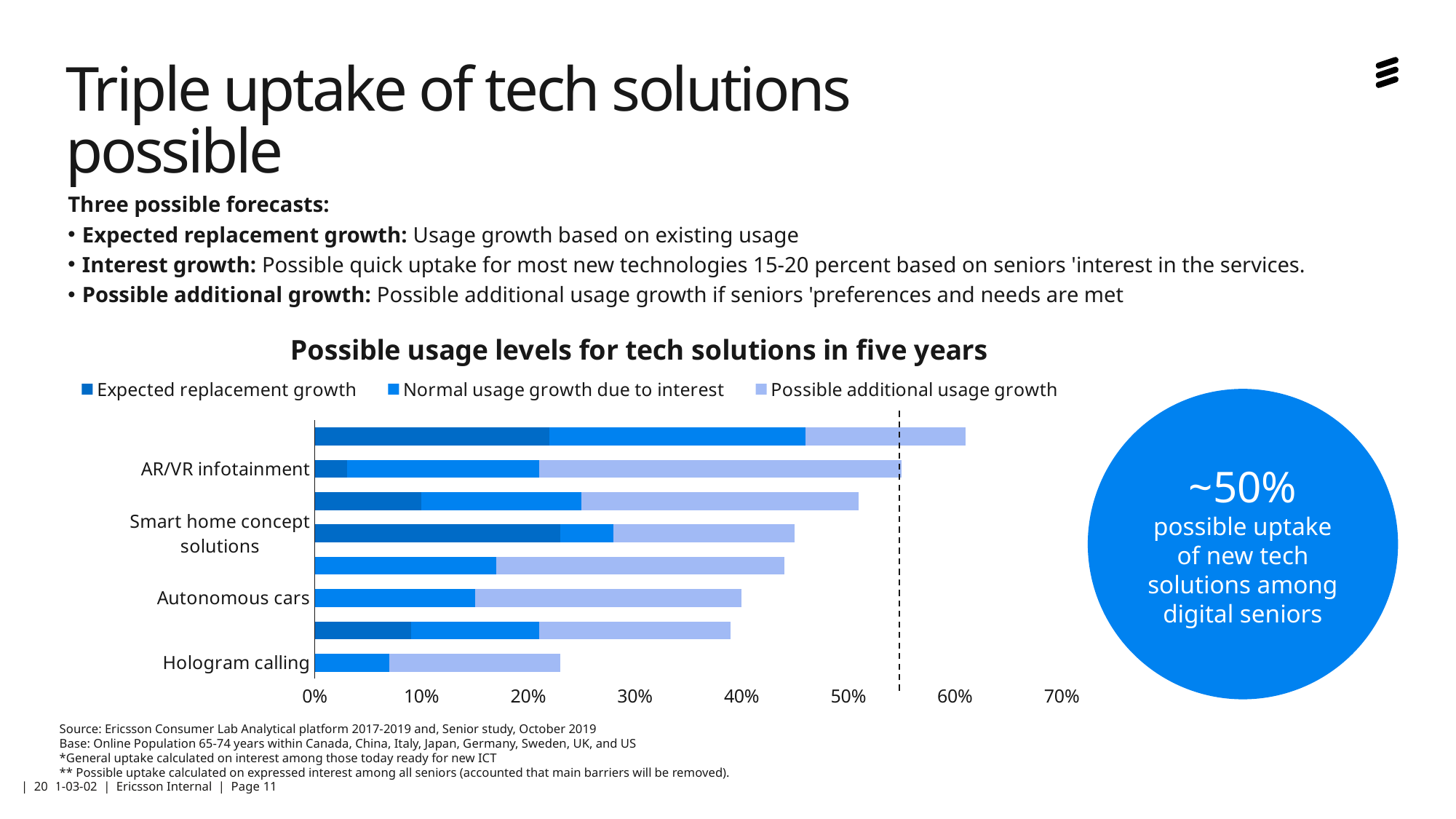
Which has the longer total bar, AR/VR infotainment or Hologram calling? AR/VR infotainment Is the total bar for Autonomous cars greater or less than 30%? greater Is the total bar for AR/VR infotainment greater or less than 50%? greater Is the total bar for Smart home concept solutions greater or less than 50%? less What kind of chart is shown on the slide? bar chart Which series is listed first in the chart legend? Expected replacement growth Which labelled category has the shortest total bar in the chart? Hologram calling How many series does the legend of the chart list? 3 How many bars are plotted in the chart? 8 Which has the longer total bar, AR/VR infotainment or Smart home concept solutions? AR/VR infotainment What is the title of the chart? Possible usage levels for tech solutions in five years